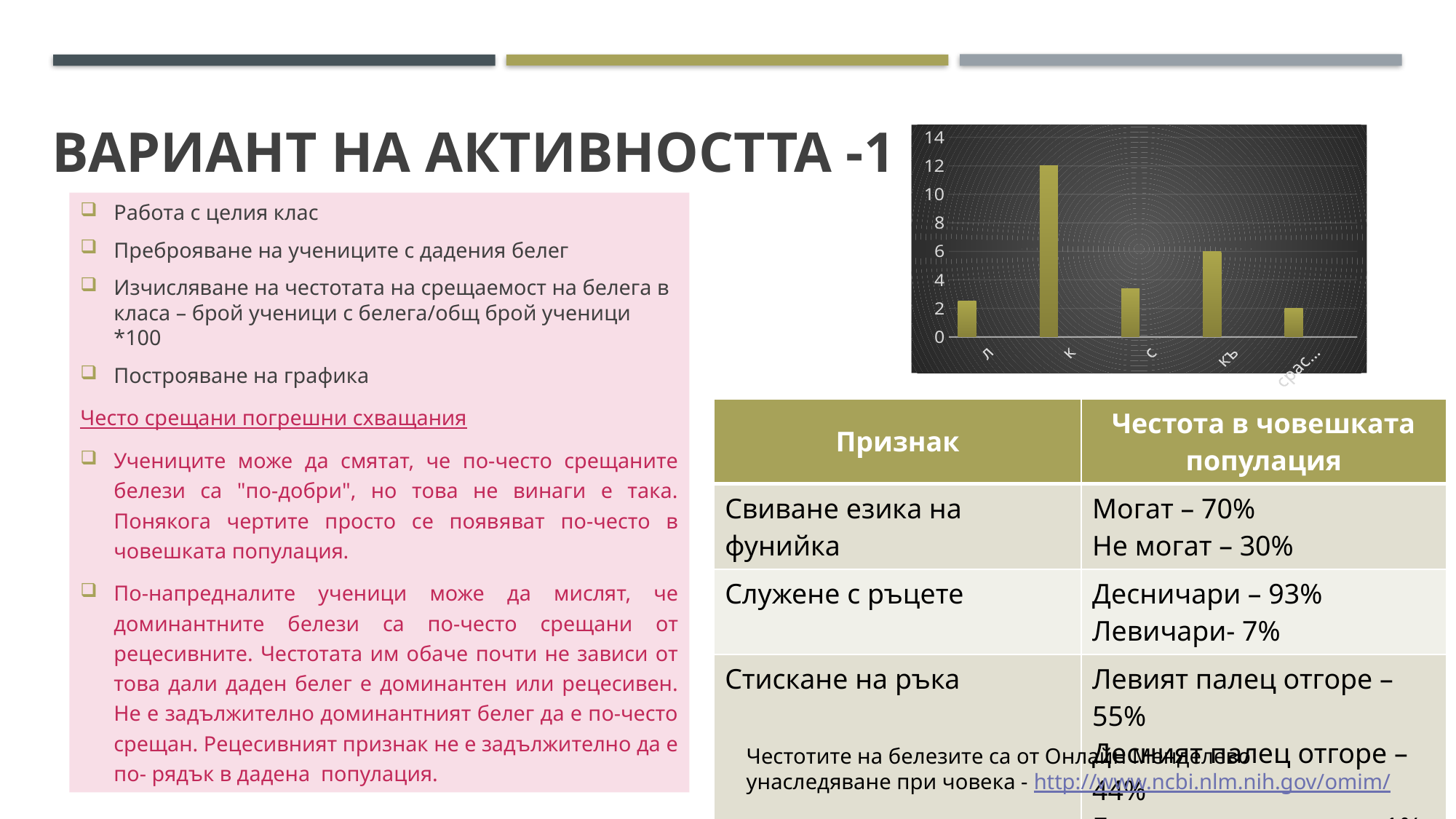
What is the highest value shown on the chart's vertical axis? 14 What is the difference between the second bar and the fourth bar in the chart? 6 Is the value of the third bar in the chart greater or less than 2? greater How many bars does the chart show? 5 What is the value of the second (tallest) bar in the chart? 12 Which bar in the chart is the highest? the second bar What is the value of the fourth bar in the chart? 6 Is the value of the first bar in the chart greater or less than 4? less What kind of chart is shown on the slide? bar chart What colour are the bars in the chart? olive/gold Which is larger in the chart, the second bar or the fourth bar? the second bar What is the value of the fifth (last) bar in the chart? 2